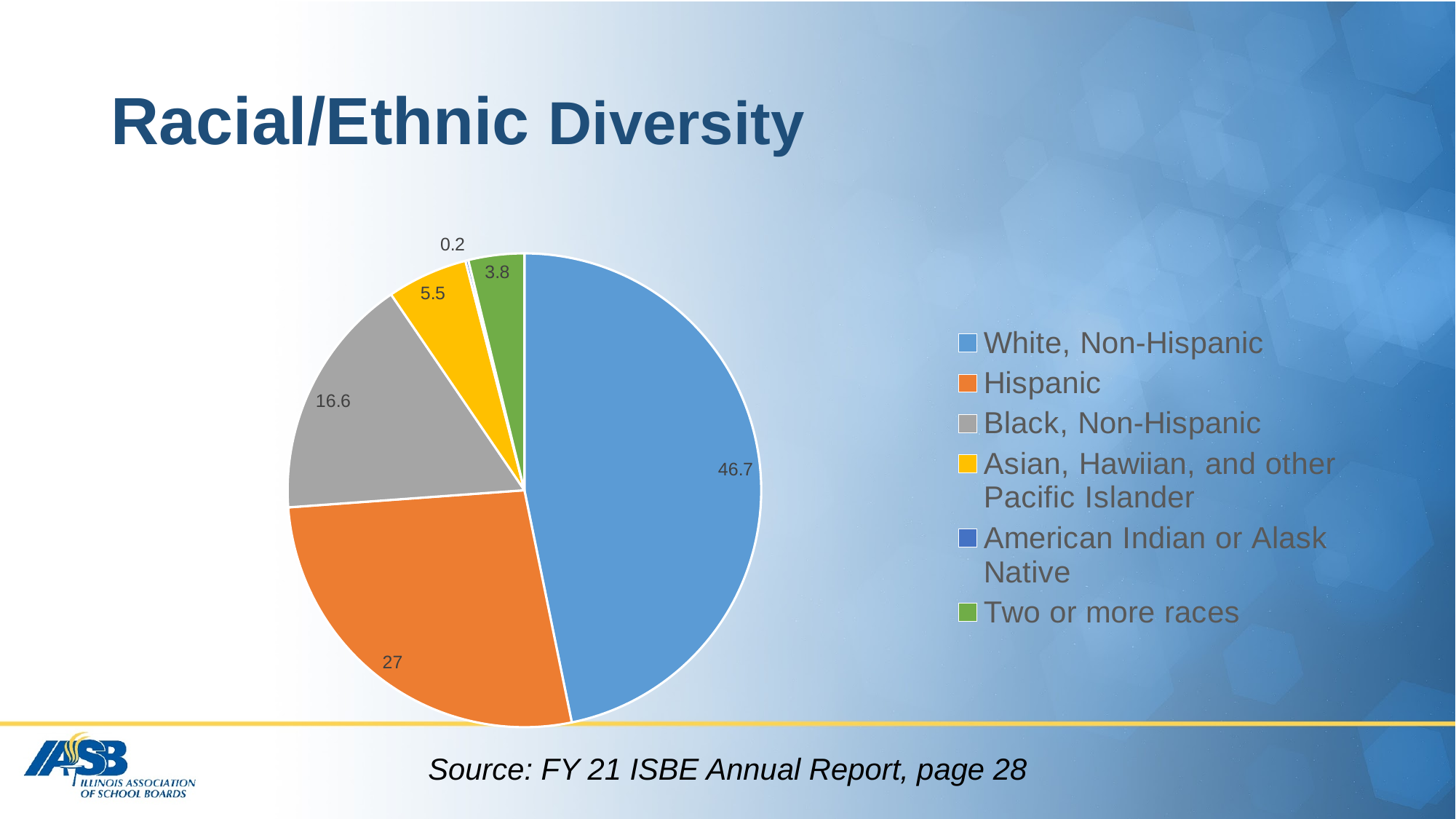
Which category has the smallest slice of the pie? American Indian or Alask Native Which category has the largest slice of the pie? White, Non-Hispanic What kind of chart is shown on the slide? pie chart What is the value shown for White, Non-Hispanic? 46.7 Which is larger, the value for Asian, Hawiian, and other Pacific Islander or the value for Two or more races? Asian, Hawiian, and other Pacific Islander What is the value shown for Black, Non-Hispanic? 16.6 What colour is the slice for Hispanic? orange What is the difference between the values for White, Non-Hispanic and Hispanic? 19.7 What is the value shown for Hispanic? 27 What is the value shown for Two or more races? 3.8 What is the difference between the values for Hispanic and Black, Non-Hispanic? 10.4 How many categories does the legend list? 6